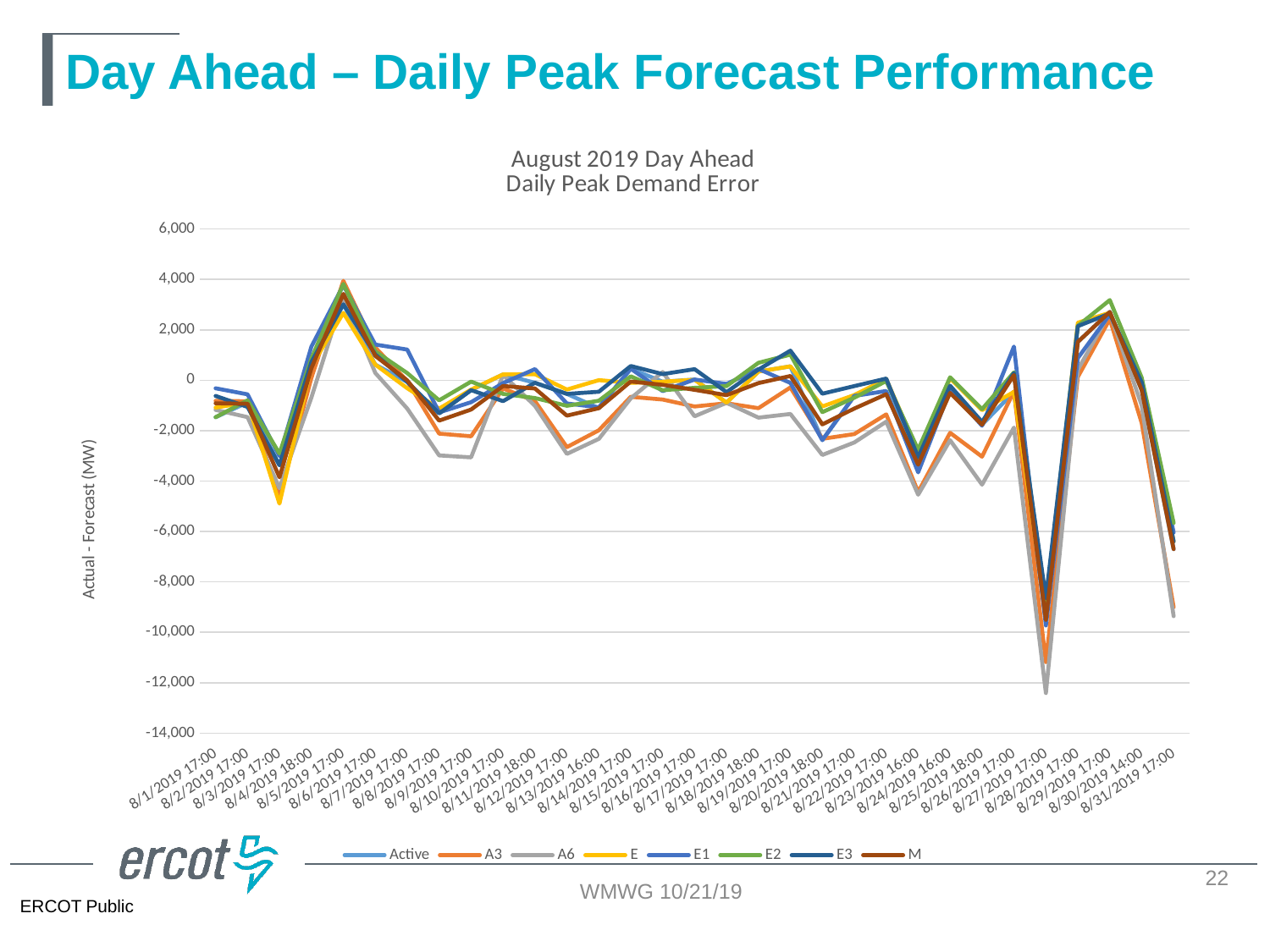
Do the series rise or fall between 8/28/2019 17:00 and 8/29/2019 17:00? rise What is the title of the chart? August 2019 Day Ahead Daily Peak Demand Error Is the value for A6 on 8/31/2019 17:00 greater or less than -8,000? less How many dates are shown along the x axis? 31 What is the label of the vertical axis? Actual - Forecast (MW) Is the value for E on 8/3/2019 17:00 greater or less than -4,000? less What kind of chart is shown on the slide? Line chart Is the value for A6 on 8/28/2019 17:00 greater or less than -10,000? greater On which date do the series reach their lowest values? 8/27/2019 17:00 On 8/28/2019 17:00, which series has the lower value, A6 or E2? A6 How many series does the legend list? 8